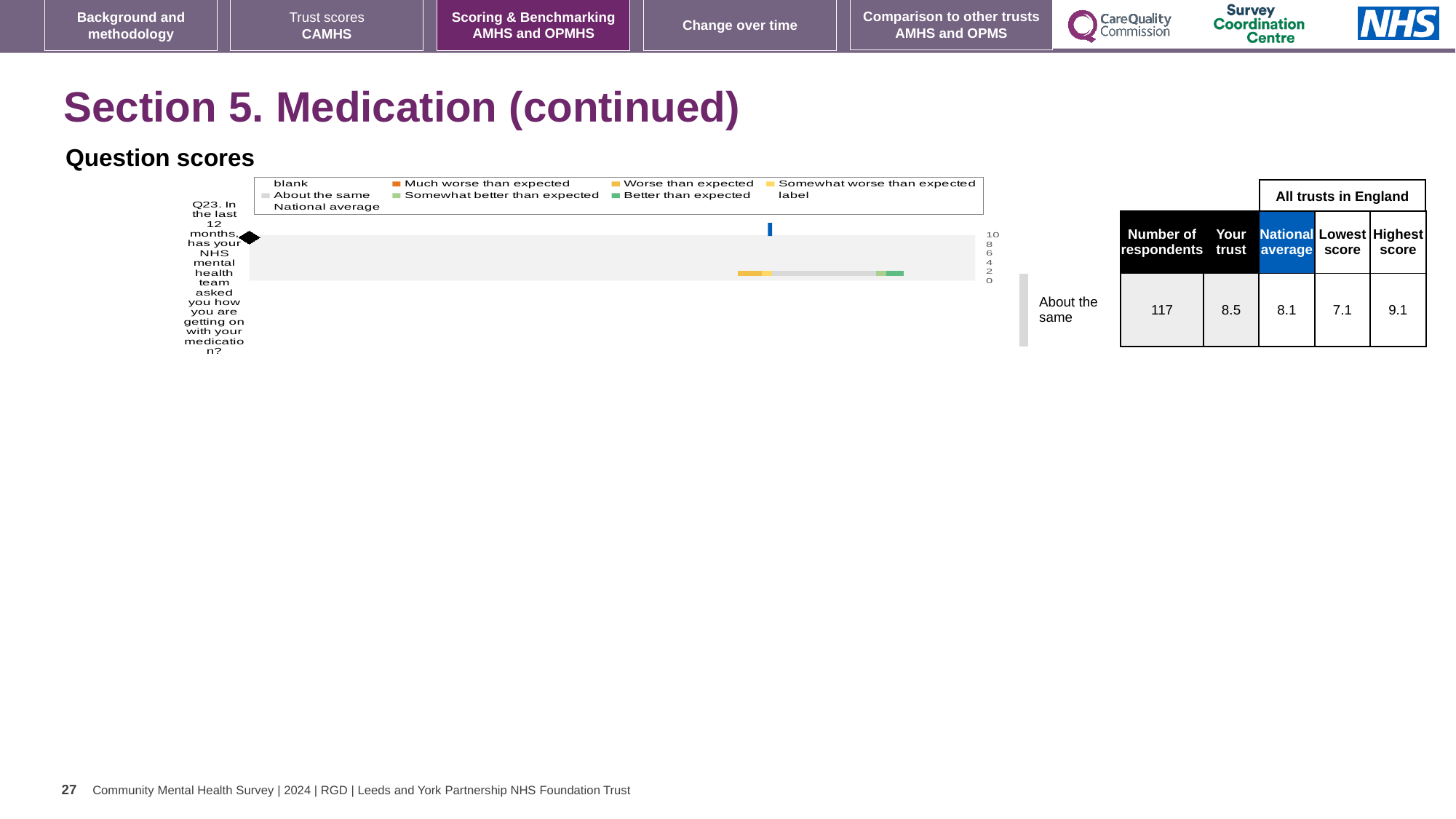
In the table next to the chart, what is the Lowest score for Q23? 7.1 How many questions (categories) are plotted in the Question scores chart? 1 What is the difference between the Highest score and the Lowest score for Q23 in the table next to the chart? 2.0 Which question is plotted in the Question scores chart? Q23. In the last 12 months, has your NHS mental health team asked you how you are getting on with your medication? According to the table next to the chart, is the 'Your trust' score for Q23 larger or smaller than the National average? larger In the table next to the chart, what is the National average for Q23? 8.1 In the table next to the chart, how many respondents answered Q23? 117 What kind of chart is shown under 'Question scores'? bar chart In the table next to the chart, what is the Highest score for Q23? 9.1 In the table next to the chart, what is the 'Your trust' score for Q23? 8.5 How many entries does the legend of the Question scores chart list? 9 What is the highest tick value shown on the axis of the Question scores chart? 10